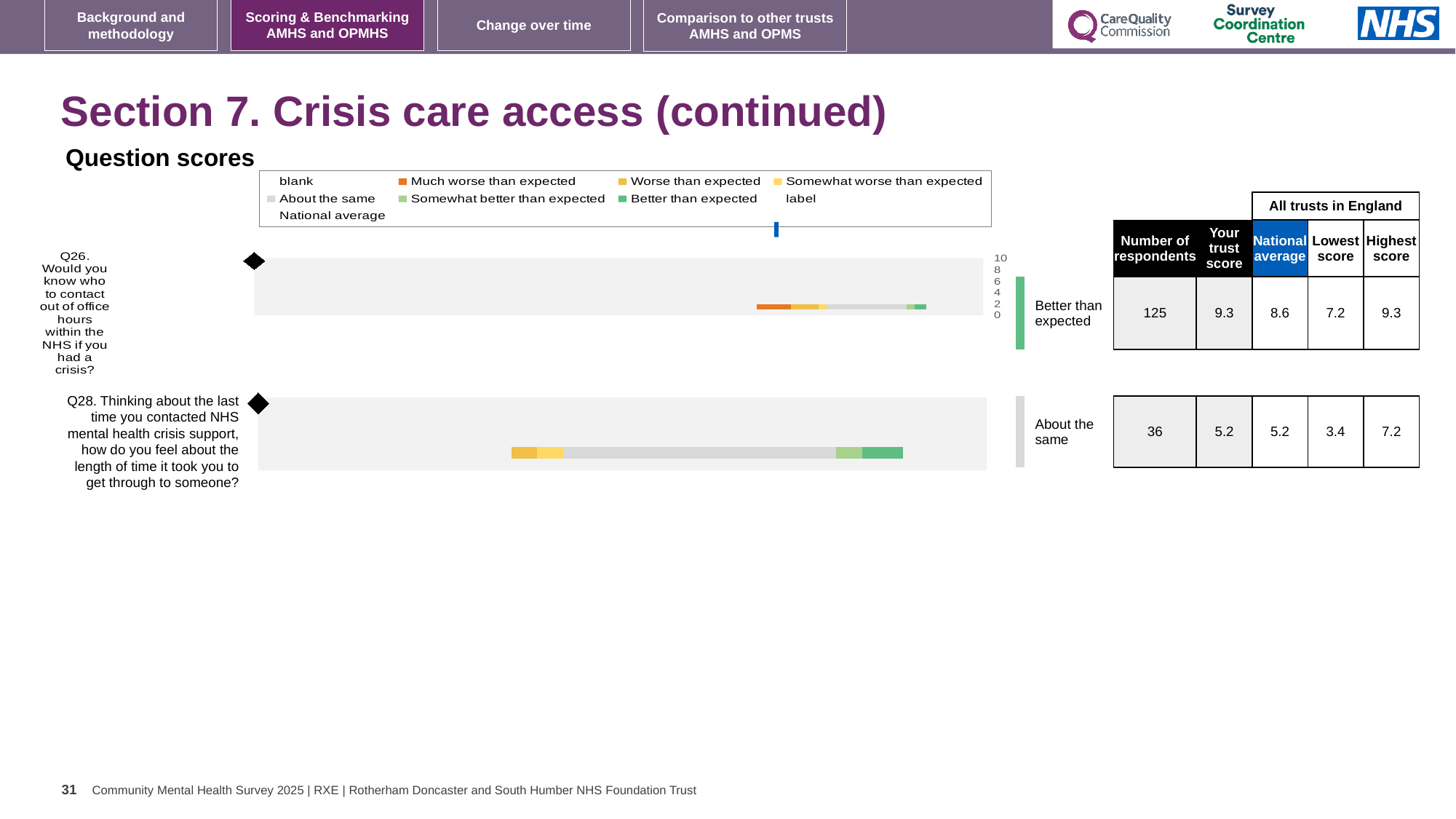
What kind of chart is used for the question scores on this slide? bar chart What is the national average score for Q26? 8.6 What is the lowest score among all trusts in England for Q28? 3.4 How many questions are plotted in the question scores chart? 2 What is the difference between the highest and lowest trust scores in England for Q26? 2.1 Which question had more respondents, Q26 or Q28? Q26 What is the trust's score for Q26 (knowing who to contact out of office hours in a crisis)? 9.3 Which question in the chart is labelled 'Better than expected'? Q26 For Q26, which is larger: the trust's score or the national average? the trust's score How many respondents answered Q28? 36 What benchmark label is shown next to the bar for Q28? About the same What is the difference between the highest and lowest trust scores in England for Q28? 3.8